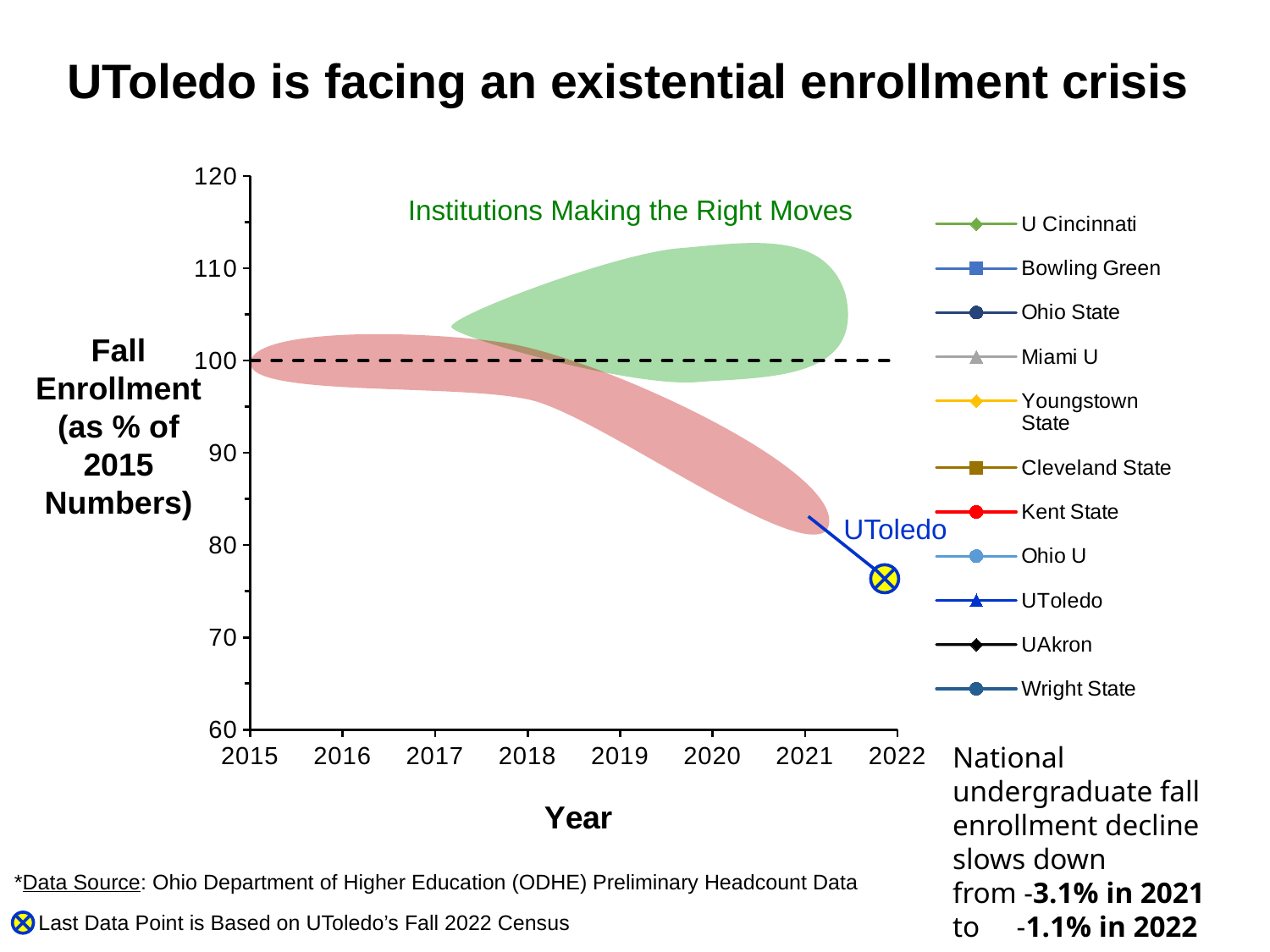
What is the label on the x axis of the chart? Year What is the highest value shown on the y axis of the chart? 120 How many years are marked along the x axis of the chart? 8 How many series does the chart's legend list? 11 What is the first series listed in the chart's legend? U Cincinnati Does the UToledo line rise or fall between 2021 and 2022? fall Is the value for UToledo in 2022 greater or less than 70? greater What kind of chart is shown on the slide? line chart Is the value for UToledo in 2022 greater or less than 80? less